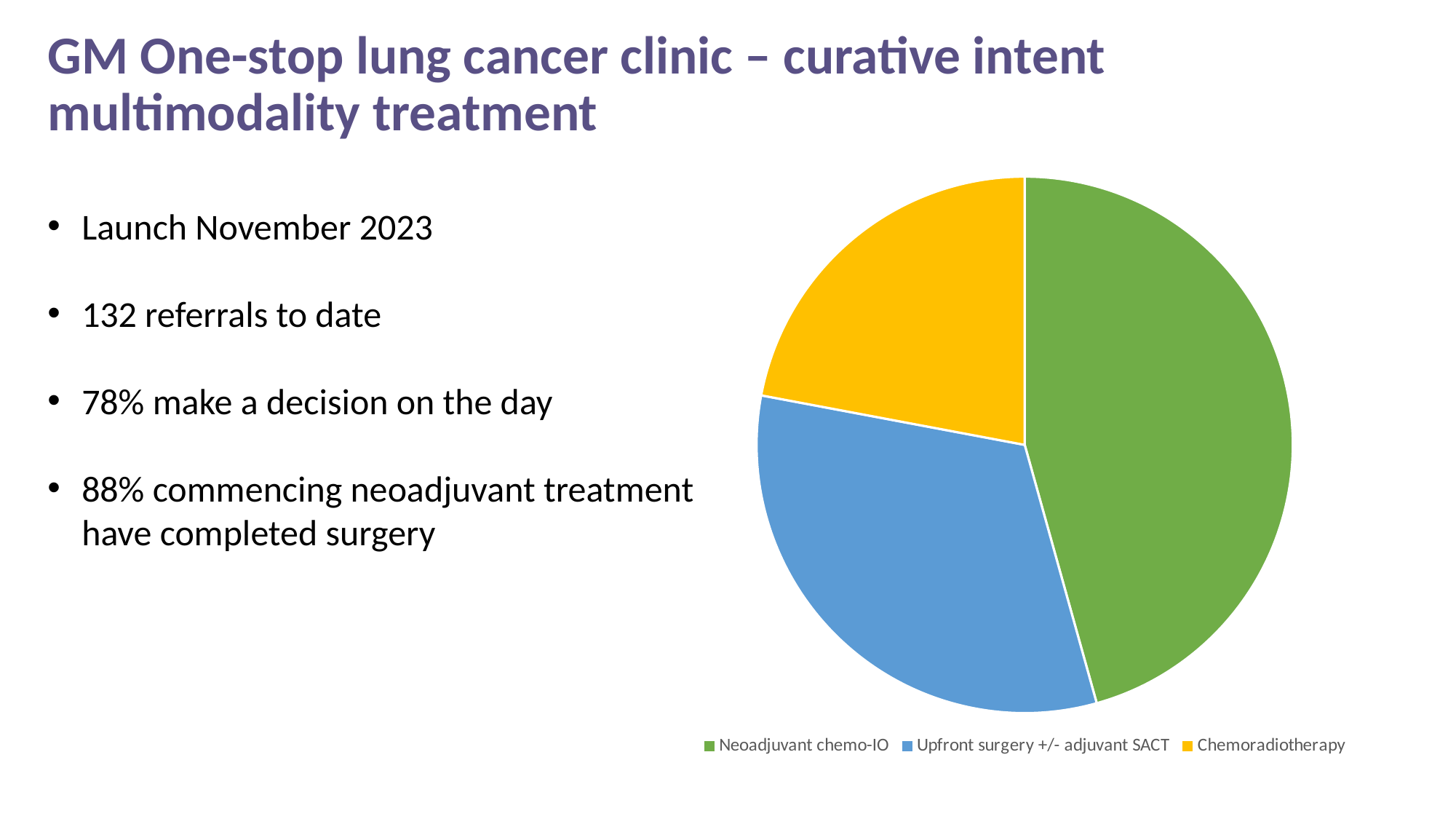
Which treatment category has the smallest slice of the pie chart? Chemoradiotherapy Which slice is larger: Neoadjuvant chemo-IO or Upfront surgery +/- adjuvant SACT? Neoadjuvant chemo-IO What kind of chart is shown on the slide? pie chart How many entries does the legend of the pie chart list? 3 Which treatment category has the largest slice of the pie chart? Neoadjuvant chemo-IO Which slice is larger: Upfront surgery +/- adjuvant SACT or Chemoradiotherapy? Upfront surgery +/- adjuvant SACT Which colour represents Chemoradiotherapy in the pie chart? yellow Which treatment category is shown in green in the pie chart? Neoadjuvant chemo-IO How many slices does the pie chart have? 3